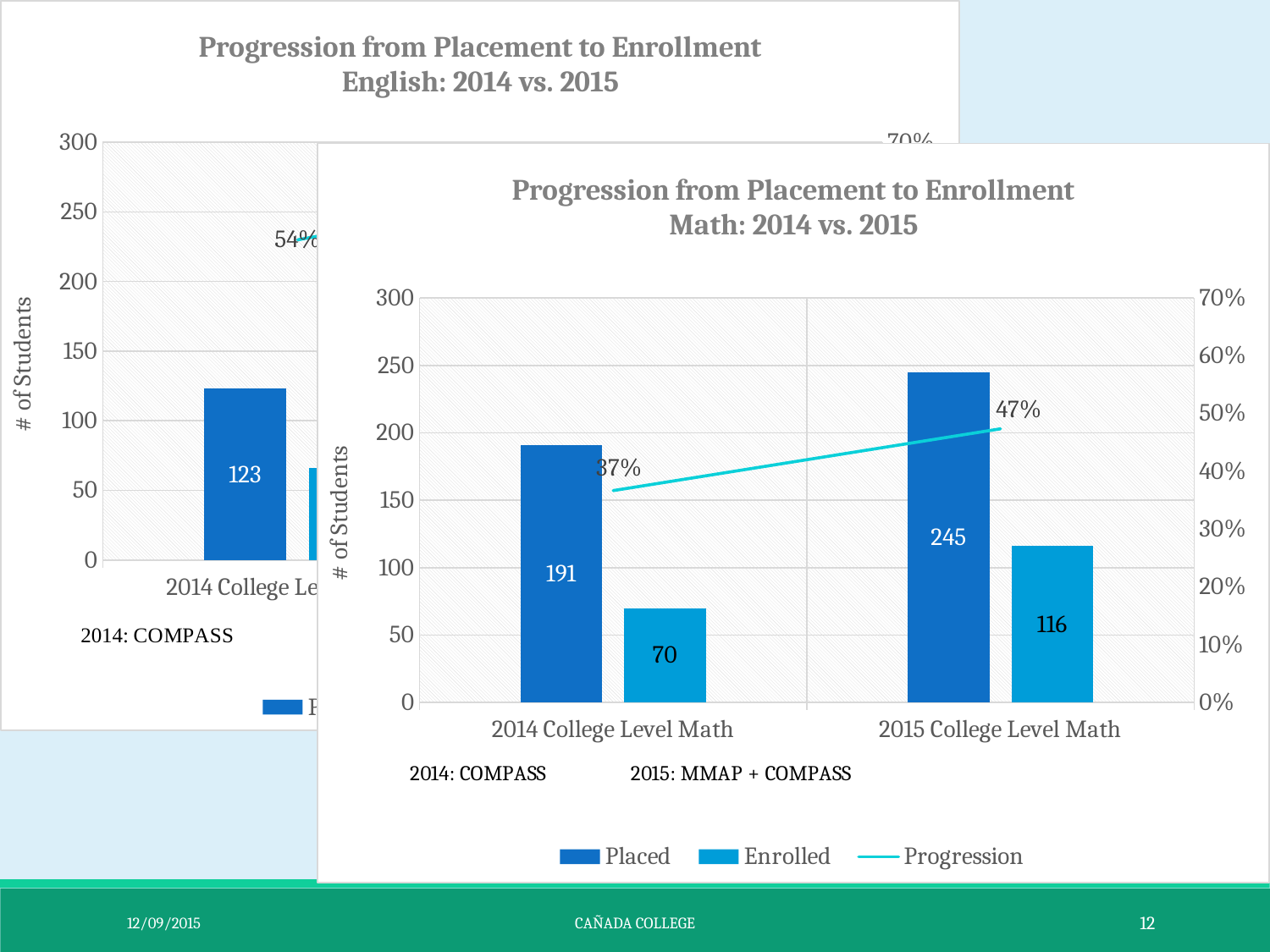
In the Math chart, which bar is the tallest? Placed, 2015 College Level Math In the Math chart, how many students were Enrolled in 2015 College Level Math? 116 In the 'Progression from Placement to Enrollment Math: 2014 vs. 2015' chart, how many students were Placed in 2014 College Level Math? 191 In the Math chart, which category has the higher number of Enrolled students, 2014 College Level Math or 2015 College Level Math? 2015 College Level Math In the Math chart, what is the Progression percentage for 2014 College Level Math? 37% How many series does the legend of the Math chart list? 3 In the Math chart, does the Progression line rise or fall from 2014 to 2015? rise In the Math chart, which bar is the shortest? Enrolled, 2014 College Level Math In the Math chart, how many more students were Placed in 2015 College Level Math than in 2014 College Level Math? 54 In the 'Progression from Placement to Enrollment English: 2014 vs. 2015' chart, how many students were Placed in 2014 College Level English? 123 In the Math chart, what is the difference between the number Placed and the number Enrolled in 2014 College Level Math? 121 In the Math chart, what is the Progression percentage for 2015 College Level Math? 47%